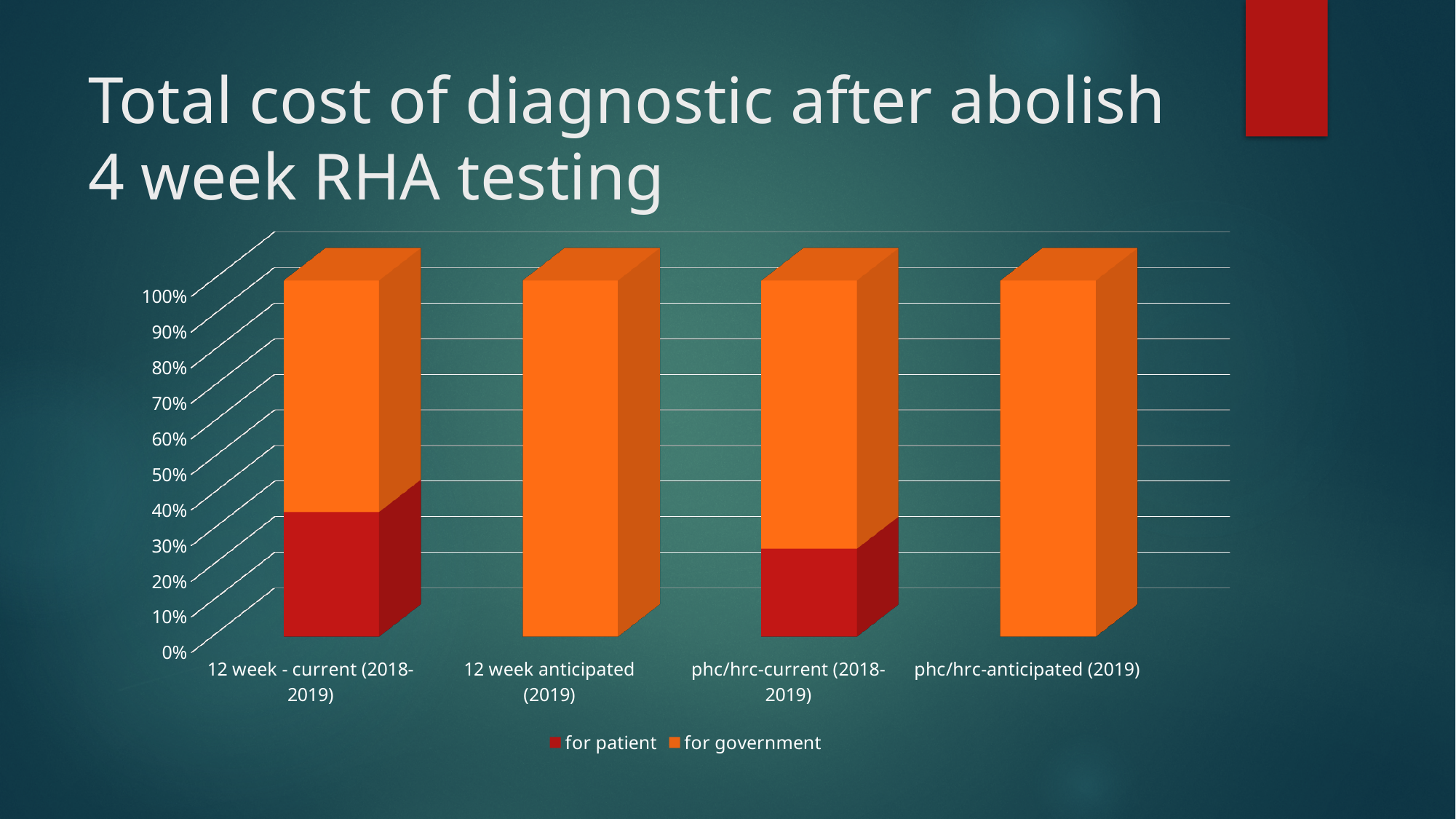
How many categories are shown on the x axis of the chart? 4 Is the 'for patient' share for '12 week - current (2018-2019)' greater or less than 30%? greater How many series does the chart legend list? 2 What kind of chart is shown on the slide? bar chart Is the 'for patient' share for 'phc/hrc-current (2018-2019)' greater or less than 20%? greater Which category has the largest 'for patient' share? 12 week - current (2018-2019) Which has a larger 'for patient' share: '12 week - current (2018-2019)' or 'phc/hrc-current (2018-2019)'? 12 week - current (2018-2019) Is the 'for patient' share for '12 week - current (2018-2019)' greater or less than 50%? less Which series is shown in red in the chart? for patient Which has a larger 'for government' share: '12 week anticipated (2019)' or '12 week - current (2018-2019)'? 12 week anticipated (2019) What is the title of the chart on the slide? Total cost of diagnostic after abolish 4 week RHA testing